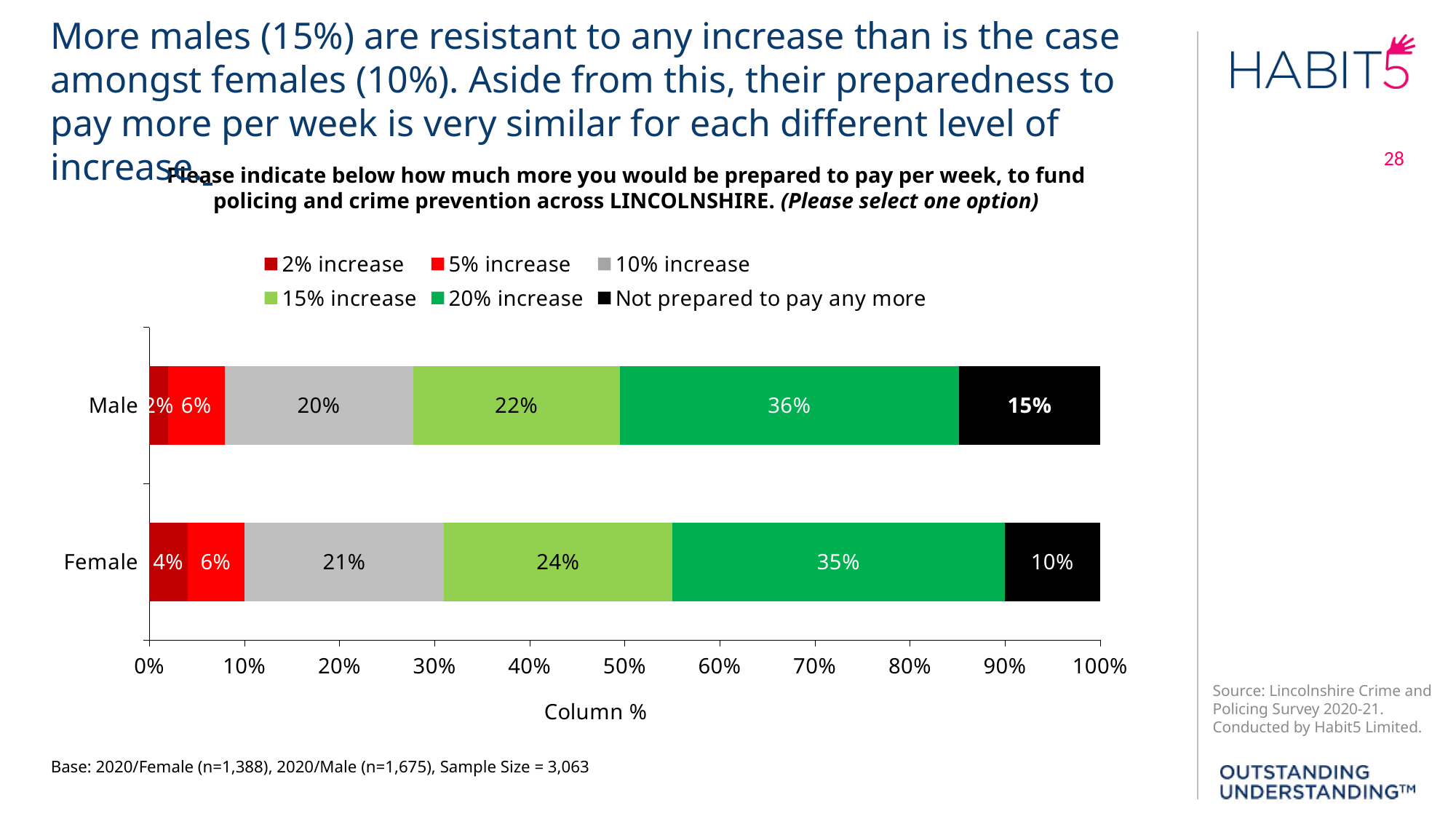
How many series does the legend list? 6 How many categories (groups) are shown on the chart? 2 Which response option has the smallest share among males? 2% increase What kind of chart is shown on the slide? Stacked bar chart What colour represents the 'Not prepared to pay any more' series? Black Which response option has the largest share among males? 20% increase What percentage of females would be prepared to pay a 20% increase? 35% What percentage of males would be prepared to pay a 10% increase? 20% What percentage of males are not prepared to pay any more? 15% What is the difference between the share of males and the share of females who are not prepared to pay any more? 5 percentage points What percentage of females would be prepared to pay a 15% increase? 24% Which group has a larger share prepared to pay a 15% increase, males or females? Females